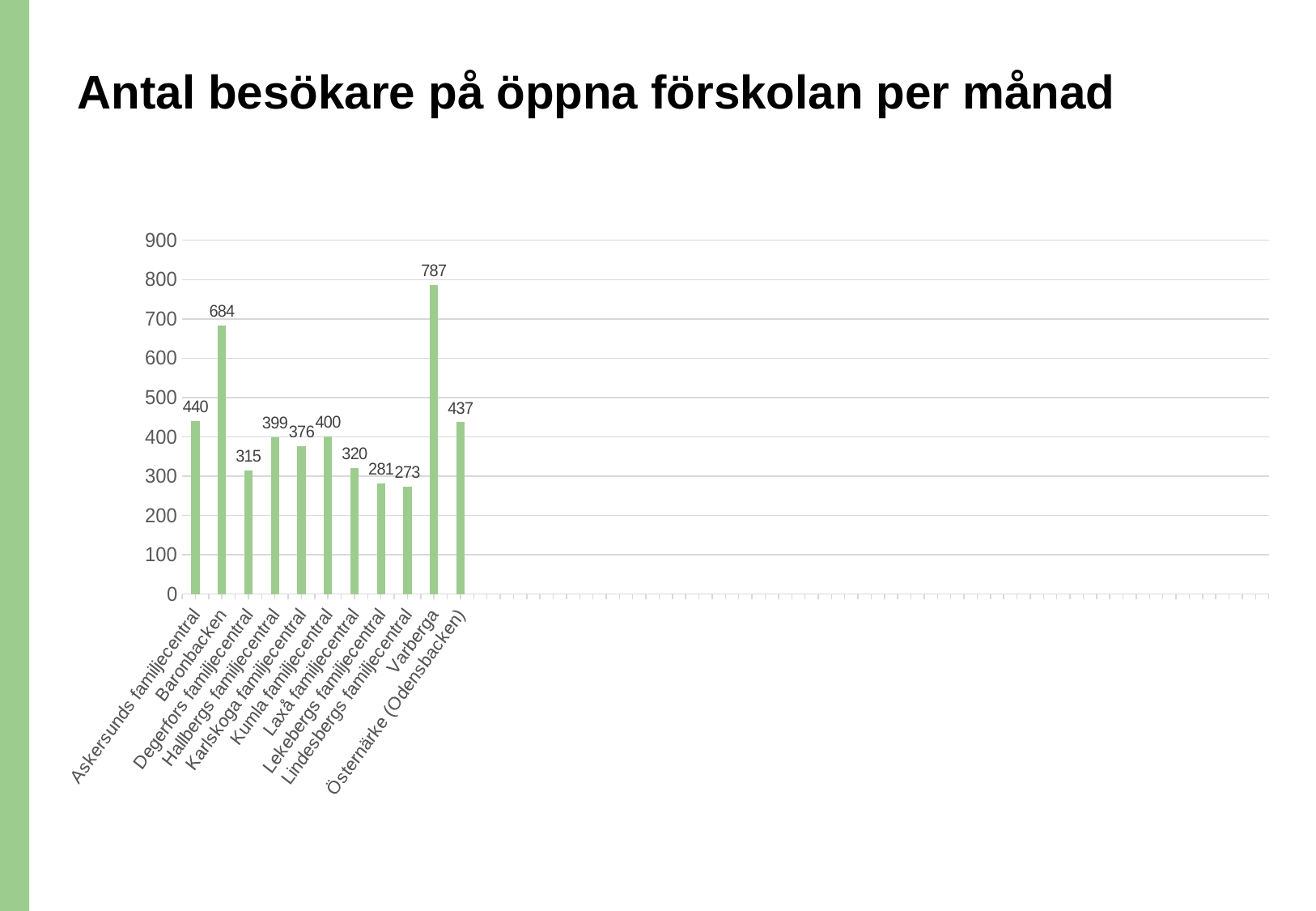
Is the value for Laxå familjecentral greater or less than 400? less Which is larger, the value for Askersunds familjecentral or the value for Östernärke (Odensbacken)? Askersunds familjecentral What is the value for Degerfors familjecentral? 315 What is the value for Varberga? 787 Which category has the lowest value? Lindesbergs familjecentral What is the difference between the values for Varberga and Baronbacken? 103 What kind of chart is shown on the slide? bar chart What is the value for Baronbacken? 684 What is the value for Östernärke (Odensbacken)? 437 How many categories are shown on the chart? 11 Which category has the highest value? Varberga What is the title of the chart? Antal besökare på öppna förskolan per månad